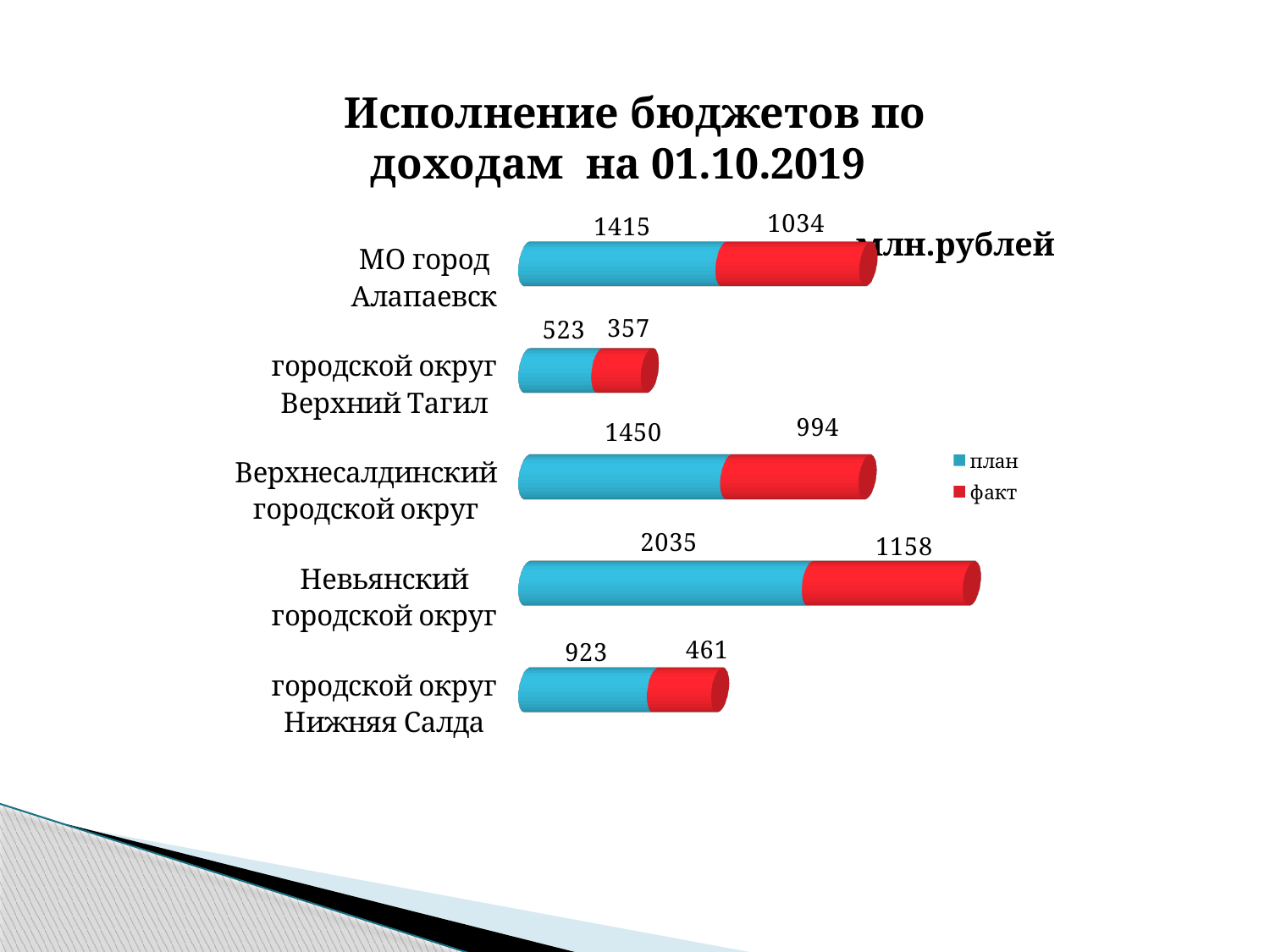
What is the difference between the план and факт values for Верхнесалдинский городской округ? 456 What is the total of the stacked bar for городской округ Нижняя Салда? 1384 How many categories are shown in the chart? 5 Which series is shown in red in the chart? факт Which is larger, the факт value for городской округ Нижняя Салда or the факт value for городской округ Верхний Тагил? городской округ Нижняя Салда What is the план value for Невьянский городской округ? 2035 How many series does the legend list? 2 Which category has the highest план value? Невьянский городской округ What kind of chart is shown on the slide? Stacked bar chart Which category has the lowest факт value? городской округ Верхний Тагил What is the факт value for МО город Алапаевск? 1034 What is the факт value for городской округ Верхний Тагил? 357